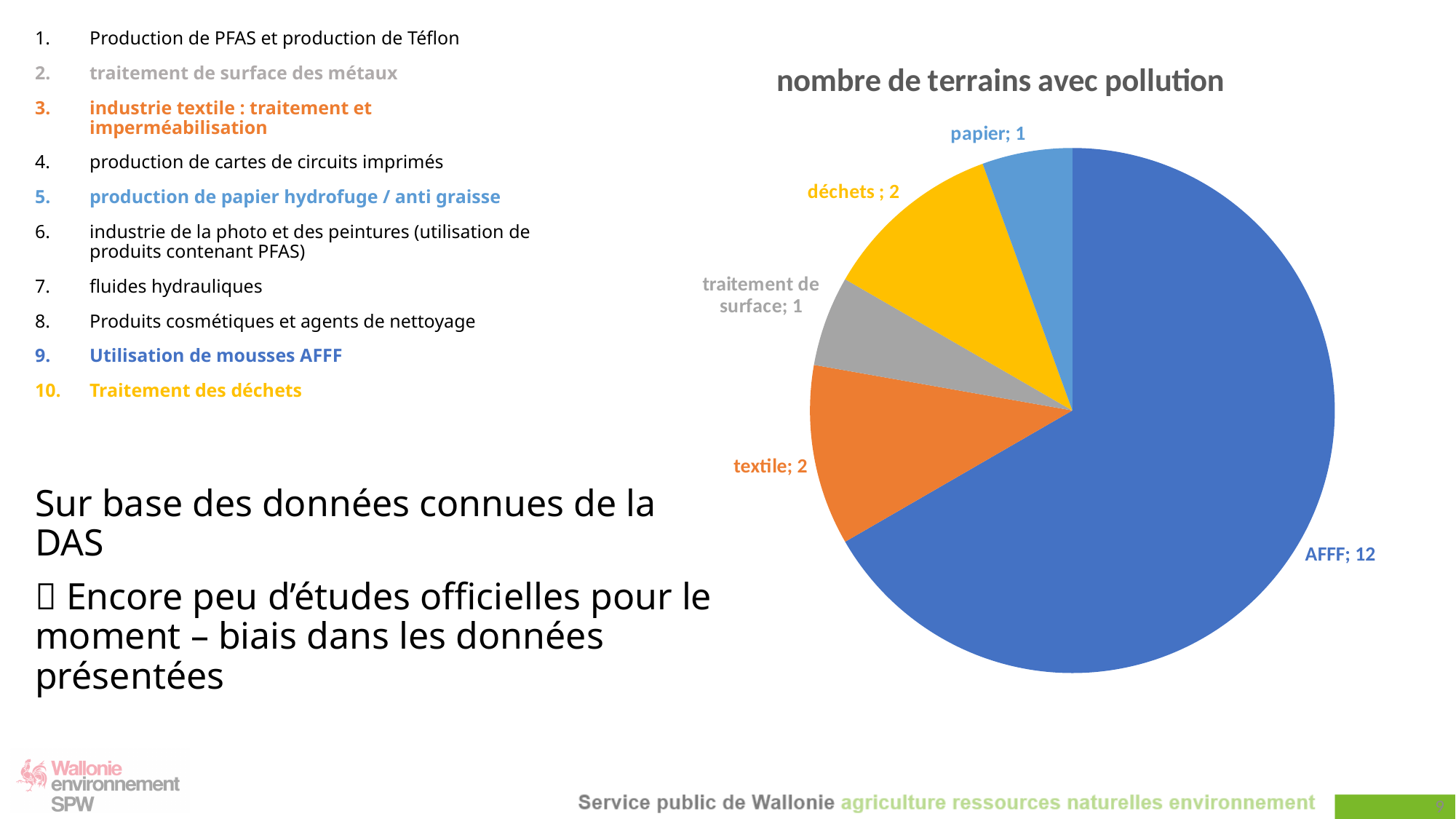
What is the total of all slices in the pie chart? 18 What is the value for papier in the pie chart? 1 Which is larger, the value for textile or the value for papier? textile What is the value for traitement de surface in the pie chart? 1 What type of chart is shown on the slide? pie chart What is the difference between the values for AFFF and déchets? 10 What is the title of the chart? nombre de terrains avec pollution What is the value for AFFF in the pie chart? 12 How many slices does the pie chart have? 5 What is the value for textile in the pie chart? 2 Which category has the largest slice in the pie chart? AFFF What colour is the AFFF slice in the pie chart? blue